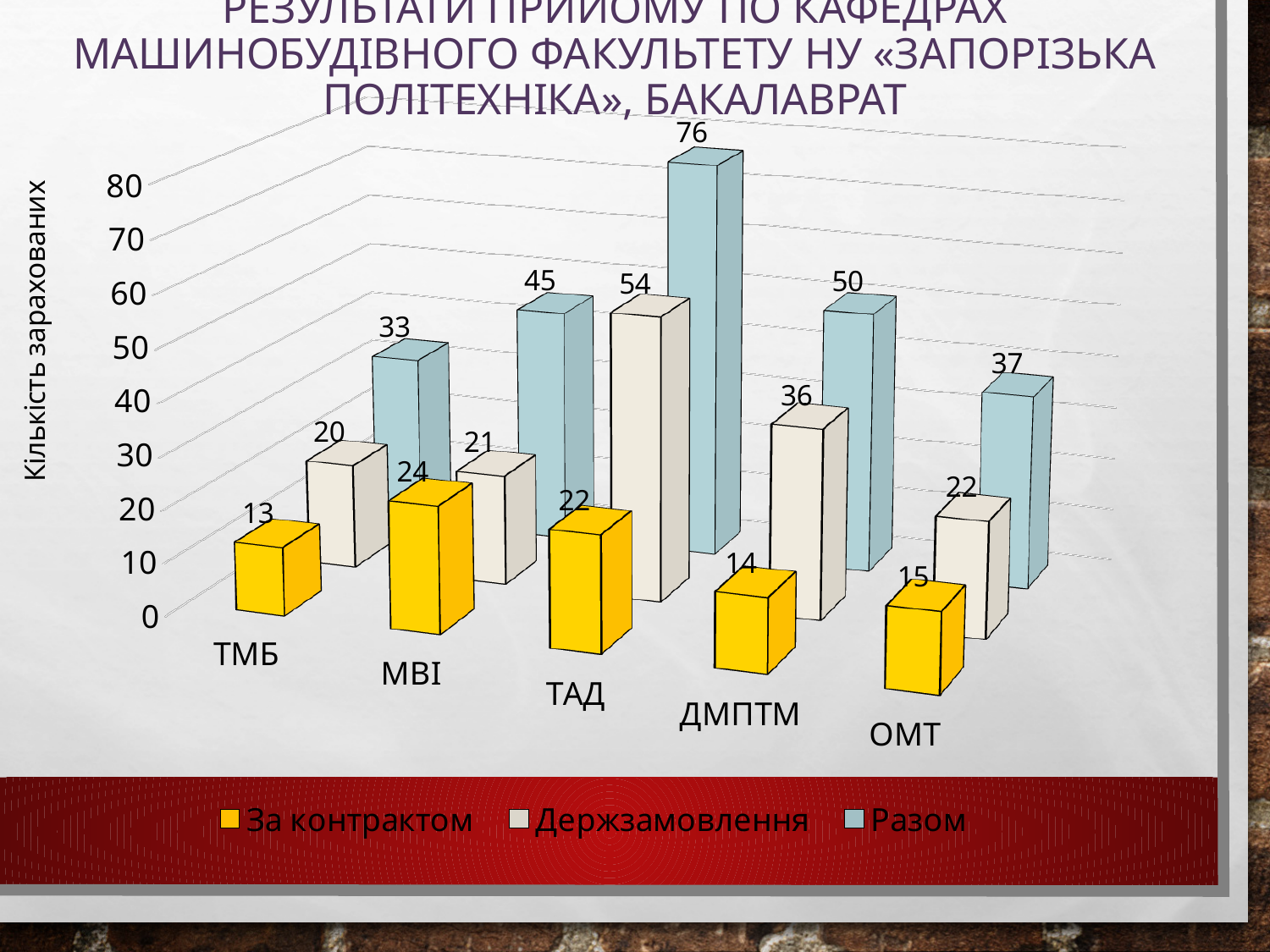
How many series does the legend list? 3 What is the label of the vertical axis? Кількість зарахованих What is the difference between Держзамовлення for ТАД and for ОМТ? 32 Which colour represents the series Разом in the legend? light blue What is the value of Разом for ТАД? 76 Which is larger: Разом for МВІ or Разом for ДМПТМ? ДМПТМ Which category has the lowest За контрактом value? ТМБ What is the value of За контрактом for МВІ? 24 Which category has the highest Разом value? ТАД What kind of chart is shown on the slide? bar chart How many categories (departments) are shown on the x axis? 5 What is the value of Держзамовлення for ДМПТМ? 36